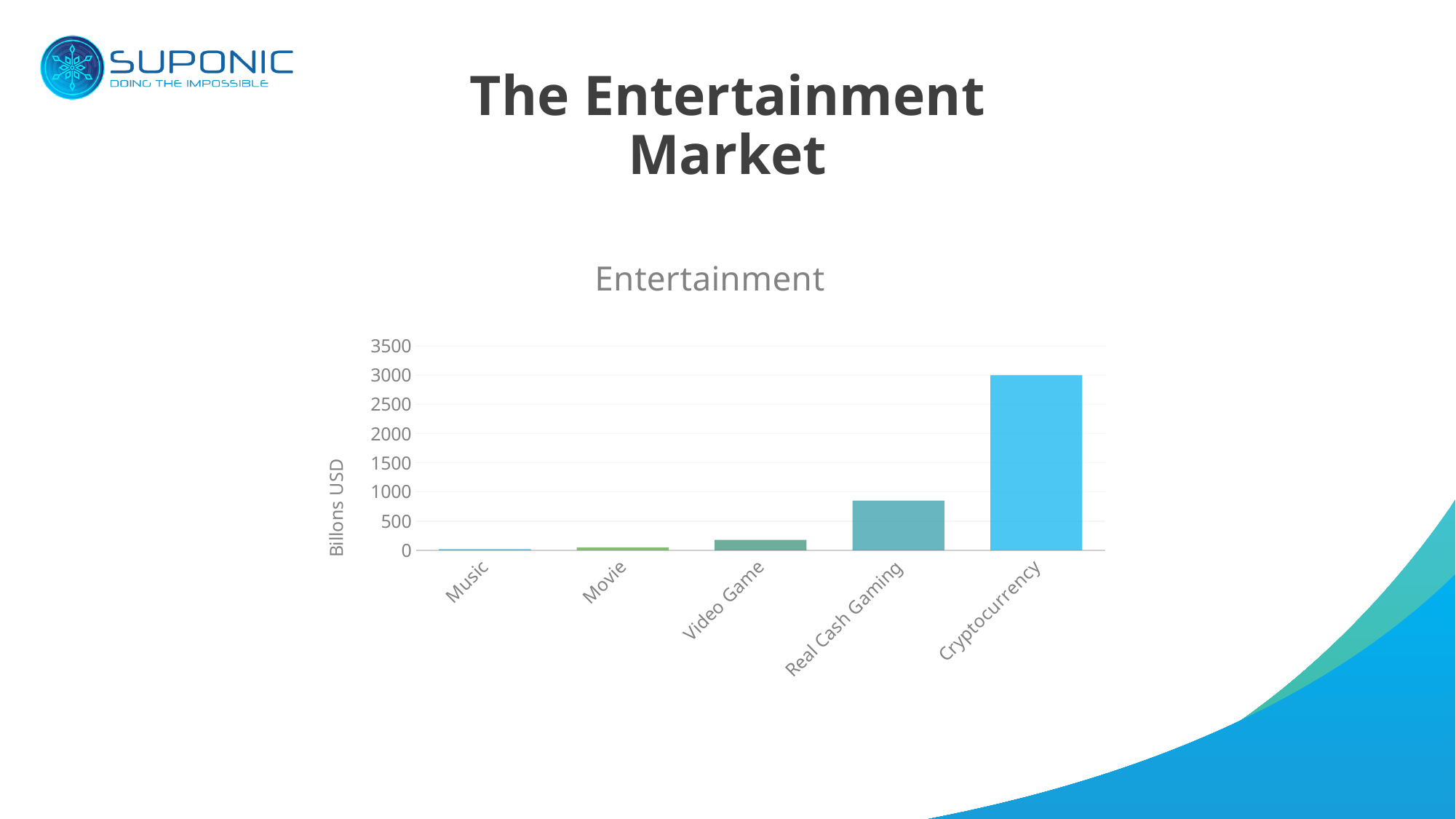
Which category has the highest value in the chart? Cryptocurrency Which category has the lowest value in the chart? Music Is the value for Cryptocurrency greater or less than 2500? greater Is the value for Video Game greater or less than 500? less What is the title of the chart? Entertainment Is the value for Real Cash Gaming greater or less than 1000? less How many categories are plotted on the x axis of the chart? 5 Which is larger, the value for Real Cash Gaming or the value for Video Game? Real Cash Gaming Do the values rise or fall moving from Music to Cryptocurrency along the x axis? rise What kind of chart is shown on the slide? bar chart What is the label on the vertical axis of the chart? Billons USD